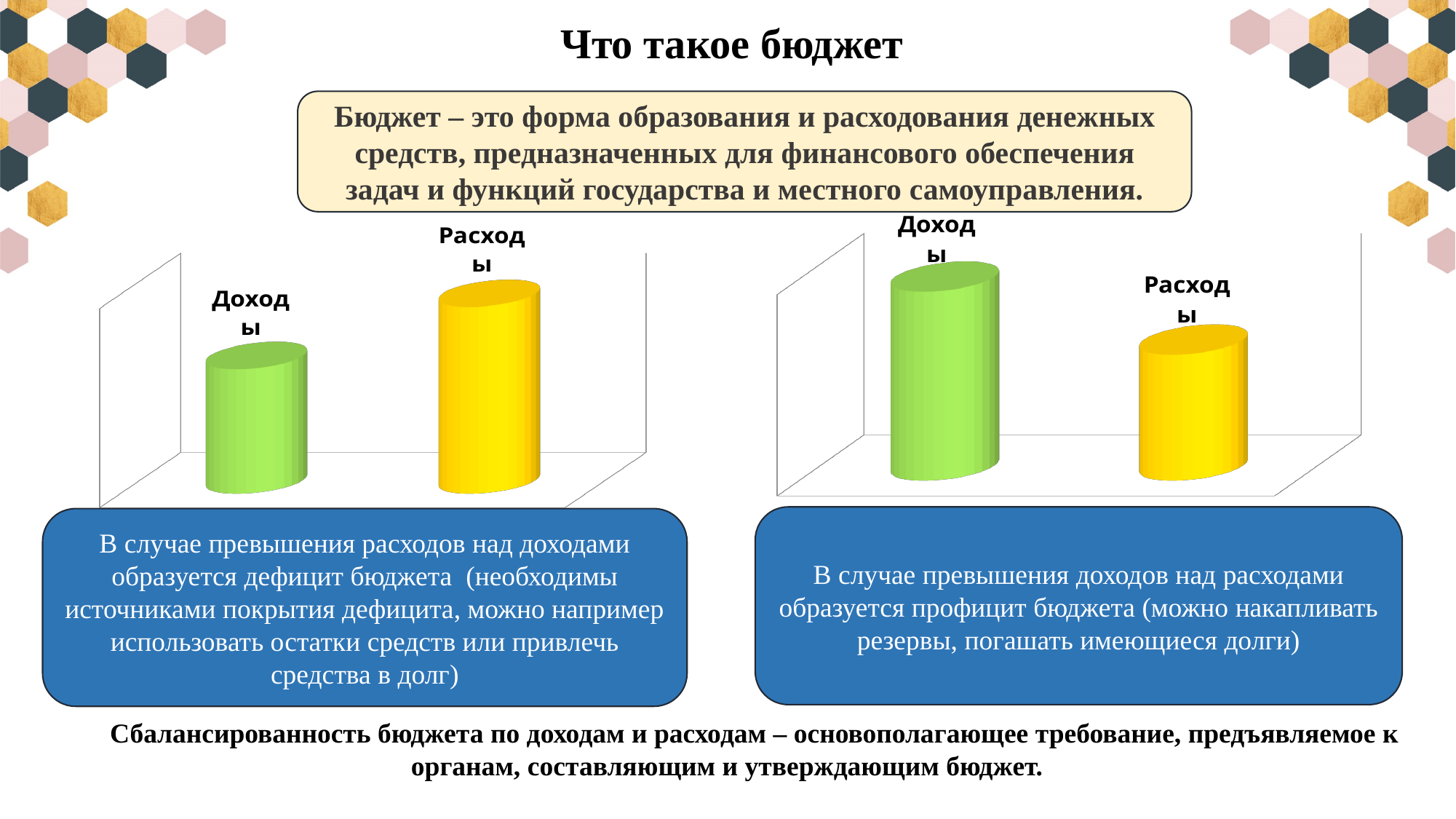
In the right chart, which category has the lowest bar? Расходы How many categories does the right chart show? 2 In the right chart, which is larger, Доходы or Расходы? Доходы How many categories does the left chart show? 2 What kind of chart is the right chart on the slide? bar chart What kind of chart is the left chart on the slide? bar chart In the left chart, what colour is the bar for Доходы? green In the right chart, what colour is the bar for Расходы? yellow In the left chart, which is larger, Доходы or Расходы? Расходы In the left chart, which category has the highest bar? Расходы In the right chart, which category has the highest bar? Доходы In the left chart, which category has the lowest bar? Доходы